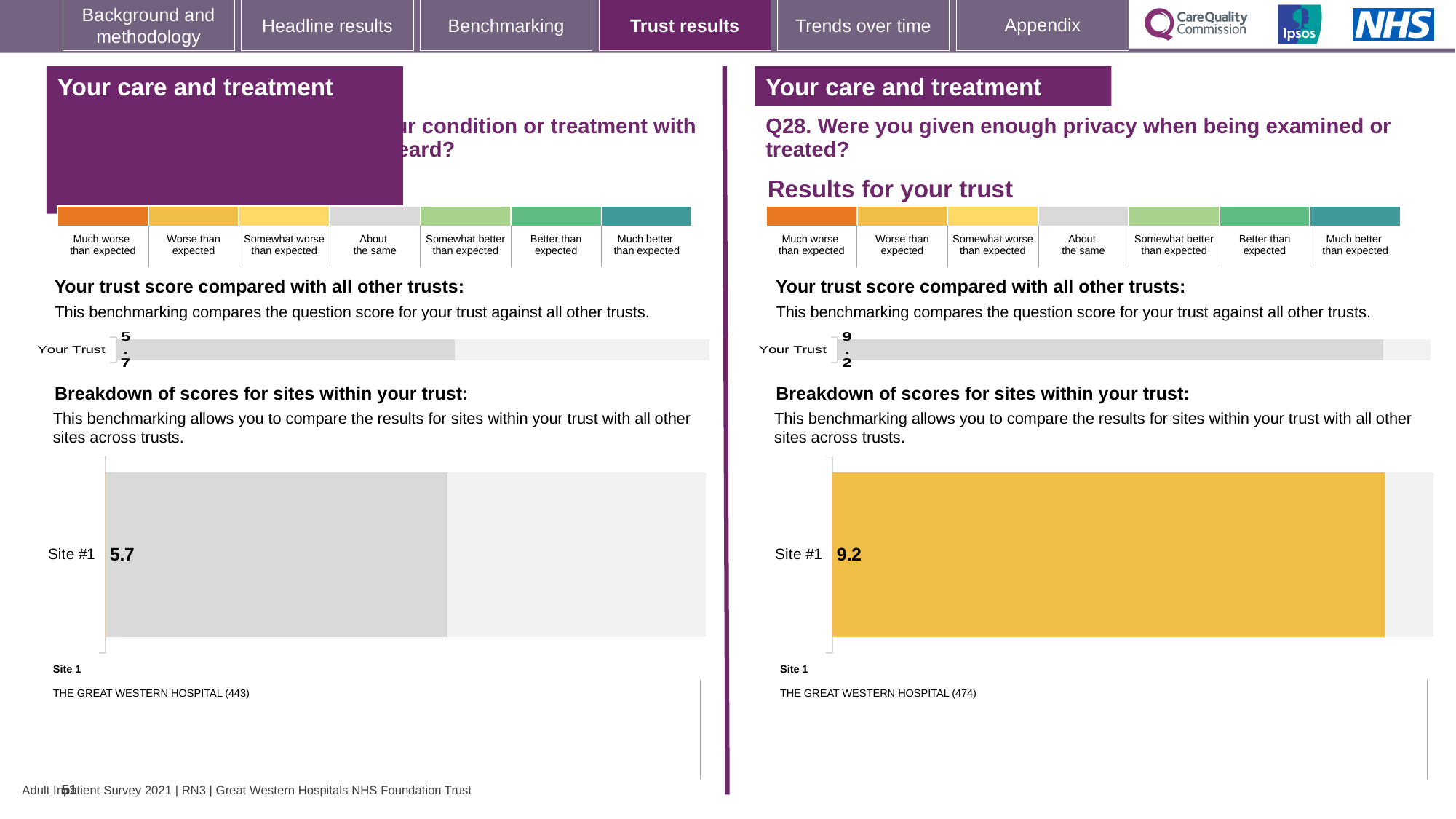
What colour is the Site #1 bar on the right-hand Q28 breakdown chart? Yellow What colour is the Site #1 bar on the left-hand breakdown chart? Grey On the right-hand Q28 'Your trust score compared with all other trusts' chart, what is the score shown for Your Trust? 9.2 What type of chart is used for the Site #1 breakdown on the right-hand Q28 section? Bar chart On the left-hand 'Your trust score compared with all other trusts' chart, what is the score shown for Your Trust? 5.7 How many sites are plotted on the left-hand 'Breakdown of scores for sites within your trust' chart? 1 On the left-hand 'Breakdown of scores for sites within your trust' chart, what is the score for Site #1? 5.7 On the right-hand Q28 'Breakdown of scores for sites within your trust' chart, what is the score for Site #1? 9.2 Which is larger: the Site #1 score on the left-hand breakdown chart or the Site #1 score on the right-hand Q28 breakdown chart? The right-hand Q28 chart (9.2) Which site name is listed as Site 1 beneath the right-hand Q28 breakdown chart? THE GREAT WESTERN HOSPITAL (474) How many sites are plotted on the right-hand Q28 'Breakdown of scores for sites within your trust' chart? 1 What is the difference between the Site #1 score on the right-hand Q28 breakdown chart and the Site #1 score on the left-hand breakdown chart? 3.5